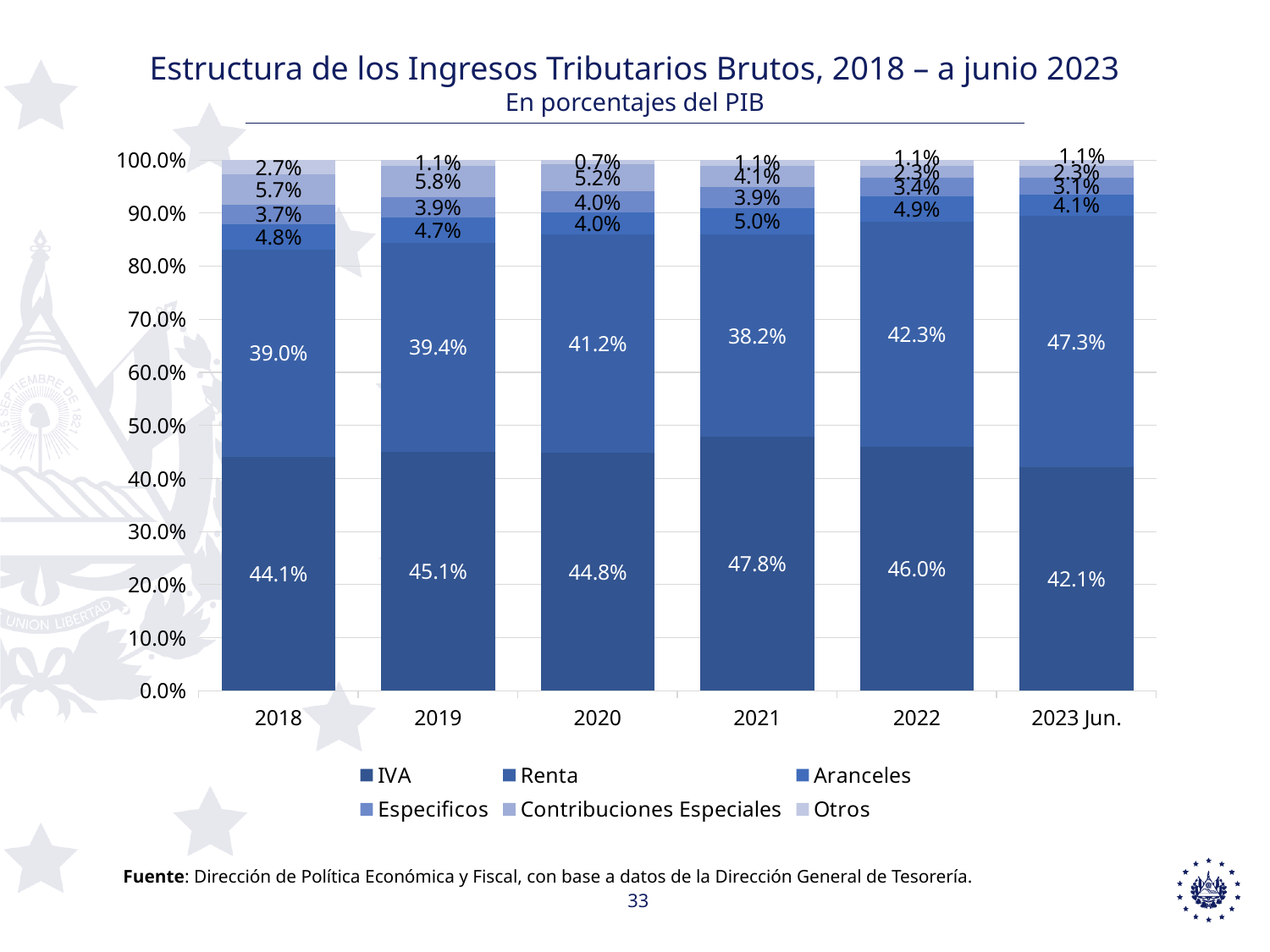
Which is larger in 2023 Jun., the IVA share or the Renta share? Renta How many series does the legend list? 6 How many years are shown on the x axis? 6 What kind of chart is shown? Stacked bar chart What is the Contribuciones Especiales share in 2019? 5.8% What is the Aranceles share in 2021? 5.0% What is the Renta share in 2023 Jun.? 47.3% What is the IVA share in 2018? 44.1% In which year is the Renta share lowest? 2021 What is the Otros share in 2020? 0.7% What is the difference between the IVA share in 2021 and in 2023 Jun.? 5.7% In which year is the IVA share highest? 2021